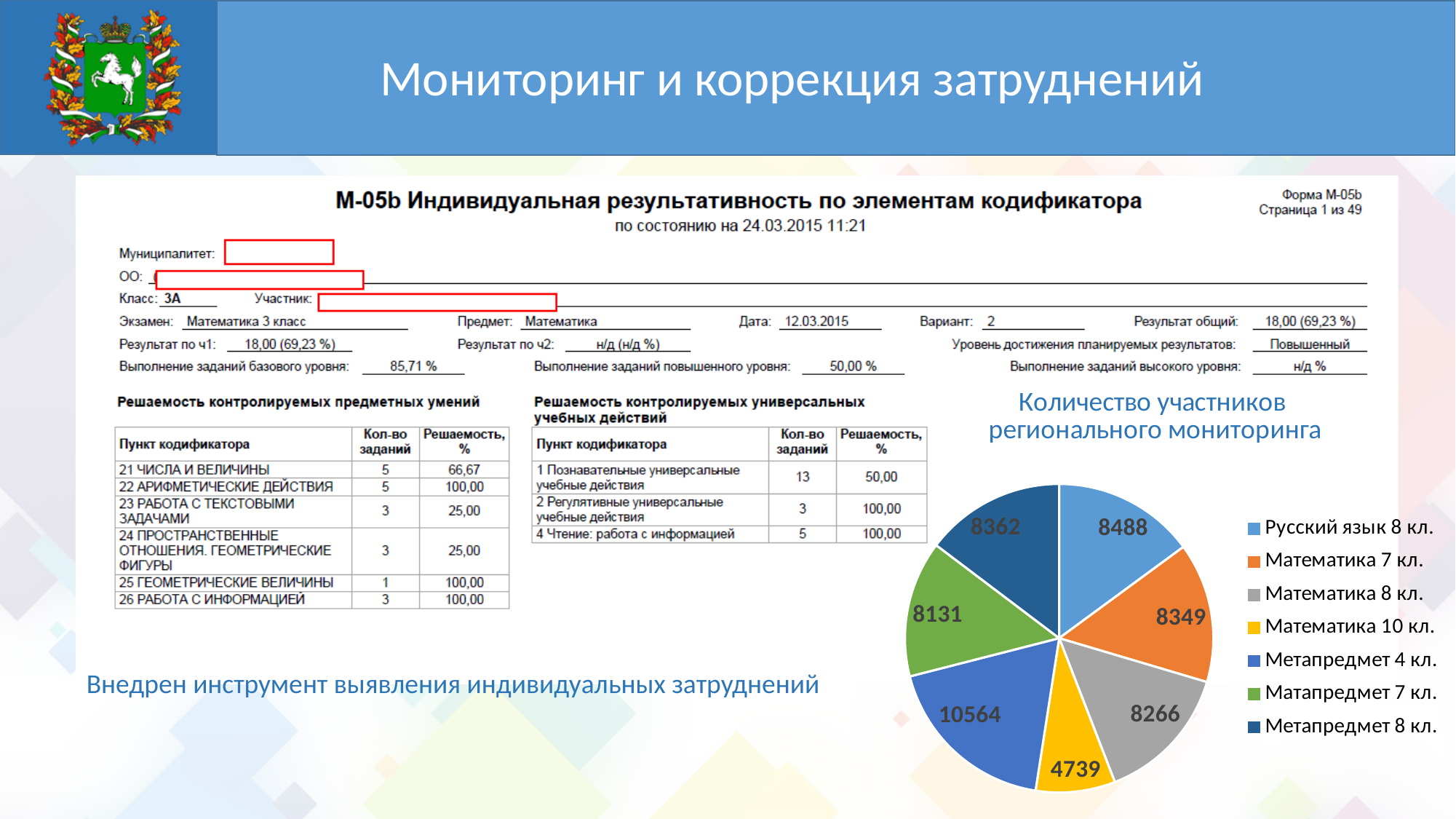
Which category has the smallest slice in the pie chart? Математика 10 кл. What is the difference between the values for Метапредмет 4 кл. and Математика 10 кл.? 5825 How many slices does the pie chart have? 7 Which is larger in the pie chart: Математика 7 кл. or Матапредмет 7 кл.? Математика 7 кл. How many entries does the legend of the pie chart list? 7 What is the value for Математика 10 кл. in the pie chart? 4739 What is the value for Русский язык 8 кл. in the pie chart? 8488 What is the title of the pie chart? Количество участников регионального мониторинга What is the value for Метапредмет 8 кл. in the pie chart? 8362 What colour is the slice for Математика 10 кл. in the pie chart? Yellow Which category has the largest slice in the pie chart? Метапредмет 4 кл. What kind of chart is shown on the slide? Pie chart